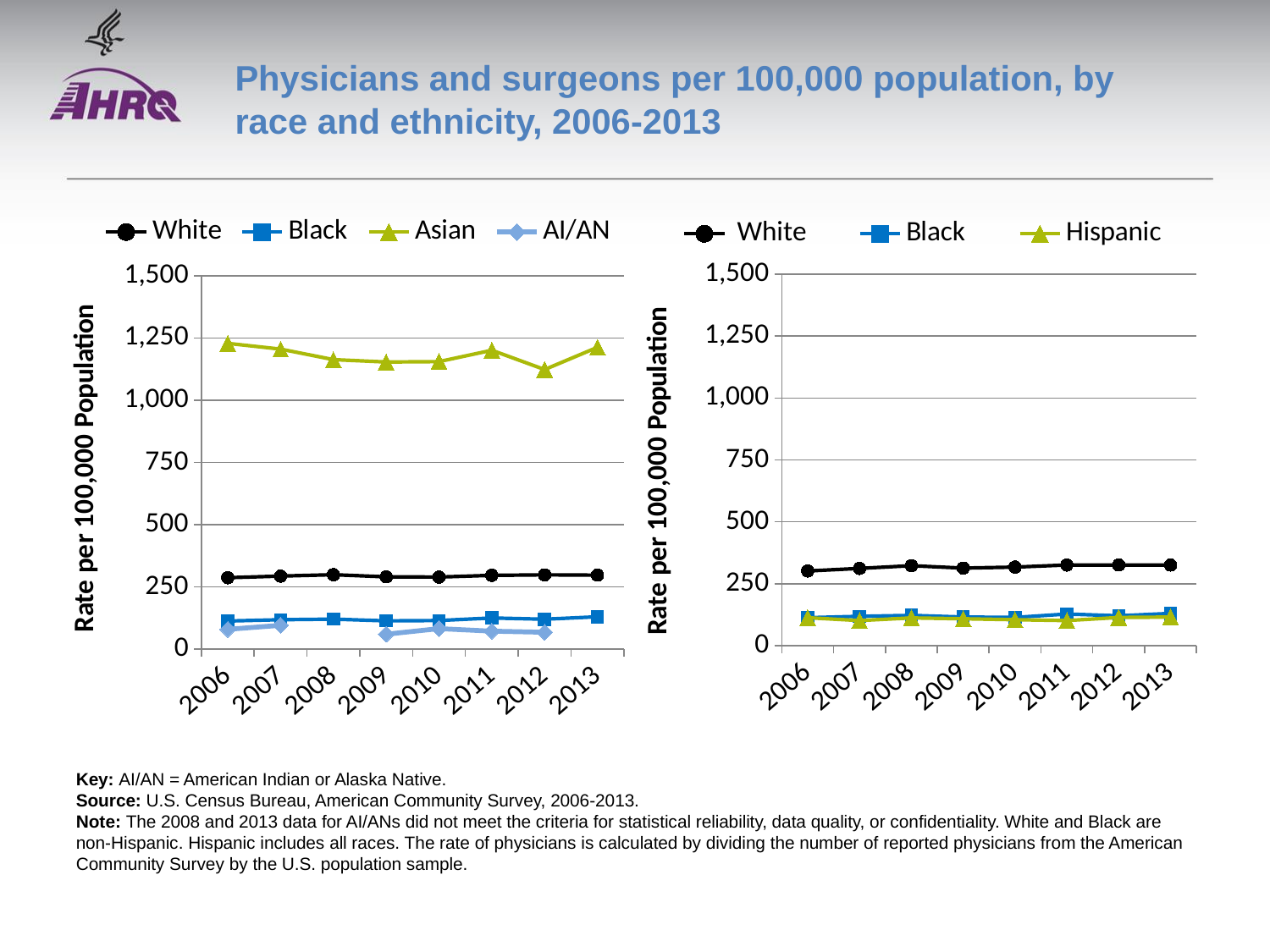
What kind of chart is the left chart on the slide? line chart In the left chart, is the value for Asian in 2006 greater or less than 1,000? greater How many series does the legend of the left chart list? 4 In the left chart, which series has the highest rate across all years? Asian In the left chart, is the value for White in 2013 greater or less than 500? less How many series does the legend of the right chart list? 3 In the right chart, which series has the highest rate in 2013? White In the left chart, which series has the lowest rate in 2009? AI/AN In the right chart, is the value for Hispanic in 2010 greater or less than 250? less How many years are shown on the x axis of the right chart? 8 What is the y-axis title of the left chart? Rate per 100,000 Population